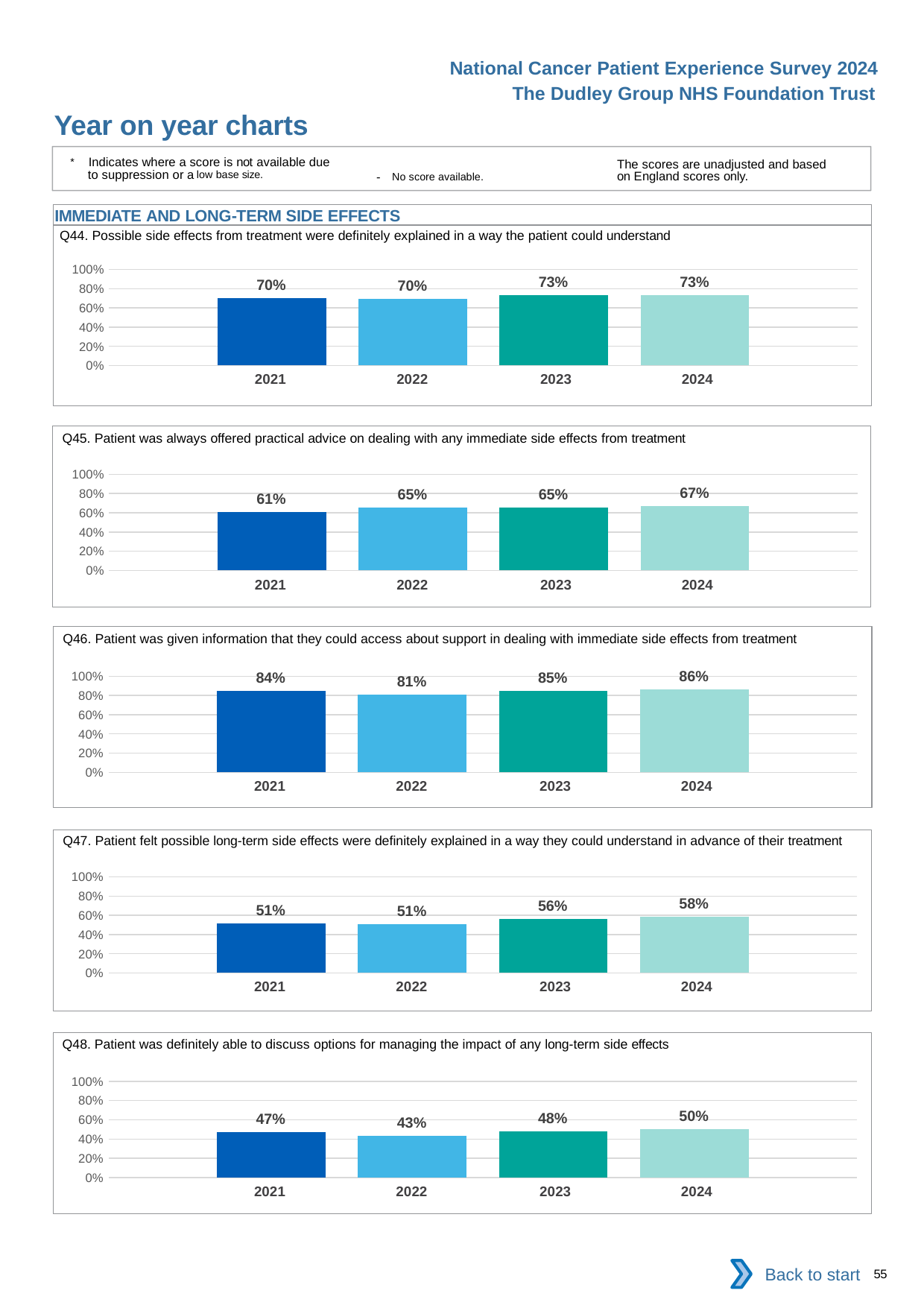
In the Q47 chart, is the value for 2021 greater or less than 60%? less In the Q44 chart, what is the value for 2023? 73% What kind of chart is the Q44 chart? Bar chart In the Q48 chart, what is the difference between the 2024 and 2022 values? 7% In the Q46 chart, which year has the lowest value? 2022 In the Q48 chart, what is the value for 2024? 50% What is the section heading above the Q44 chart? IMMEDIATE AND LONG-TERM SIDE EFFECTS In the Q47 chart, which year has the highest value? 2024 In the Q45 chart, what is the value for 2021? 61% In the Q47 chart, do the values rise or fall from 2022 to 2024? Rise How many years are shown in the Q46 chart? 4 In the Q45 chart, is the value for 2024 larger than the value for 2021? Yes